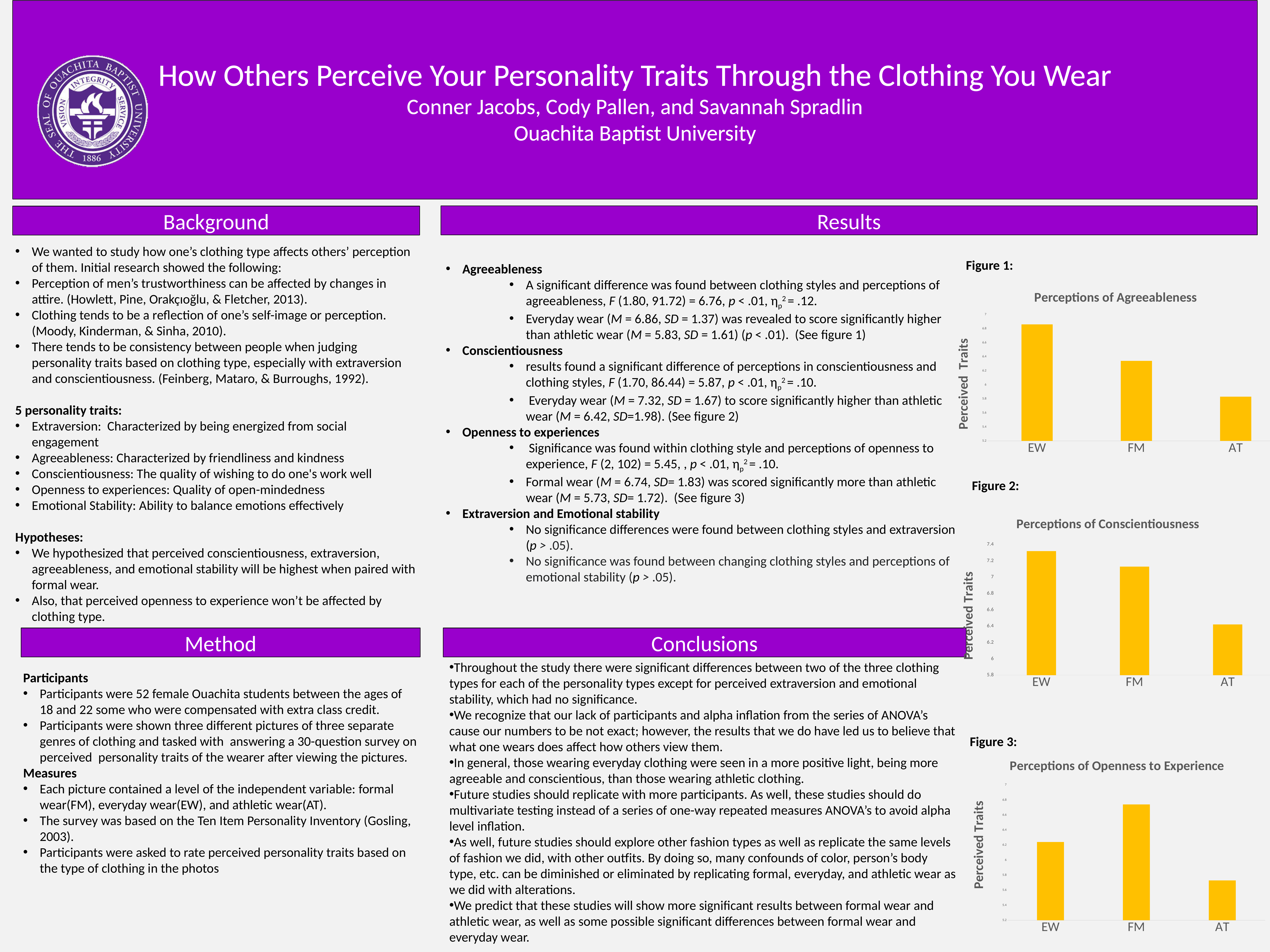
In the Perceptions of Conscientiousness chart, which category has the lowest bar? AT What type of chart is the Perceptions of Agreeableness chart? bar chart In the Perceptions of Openness to Experience chart, which is larger, EW or AT? EW In the Perceptions of Conscientiousness chart, is the value for AT greater or less than 6.6? less In the Perceptions of Openness to Experience chart, is the value for AT greater or less than 6? less In the Perceptions of Conscientiousness chart, which category has the highest bar? EW In the Perceptions of Agreeableness chart, which category has the lowest bar? AT In the Perceptions of Agreeableness chart, is the value for AT greater or less than 6? less How many categories are shown in the Perceptions of Conscientiousness chart? 3 In the Perceptions of Openness to Experience chart, which category has the highest bar? FM In the Perceptions of Agreeableness chart, which category has the highest bar? EW